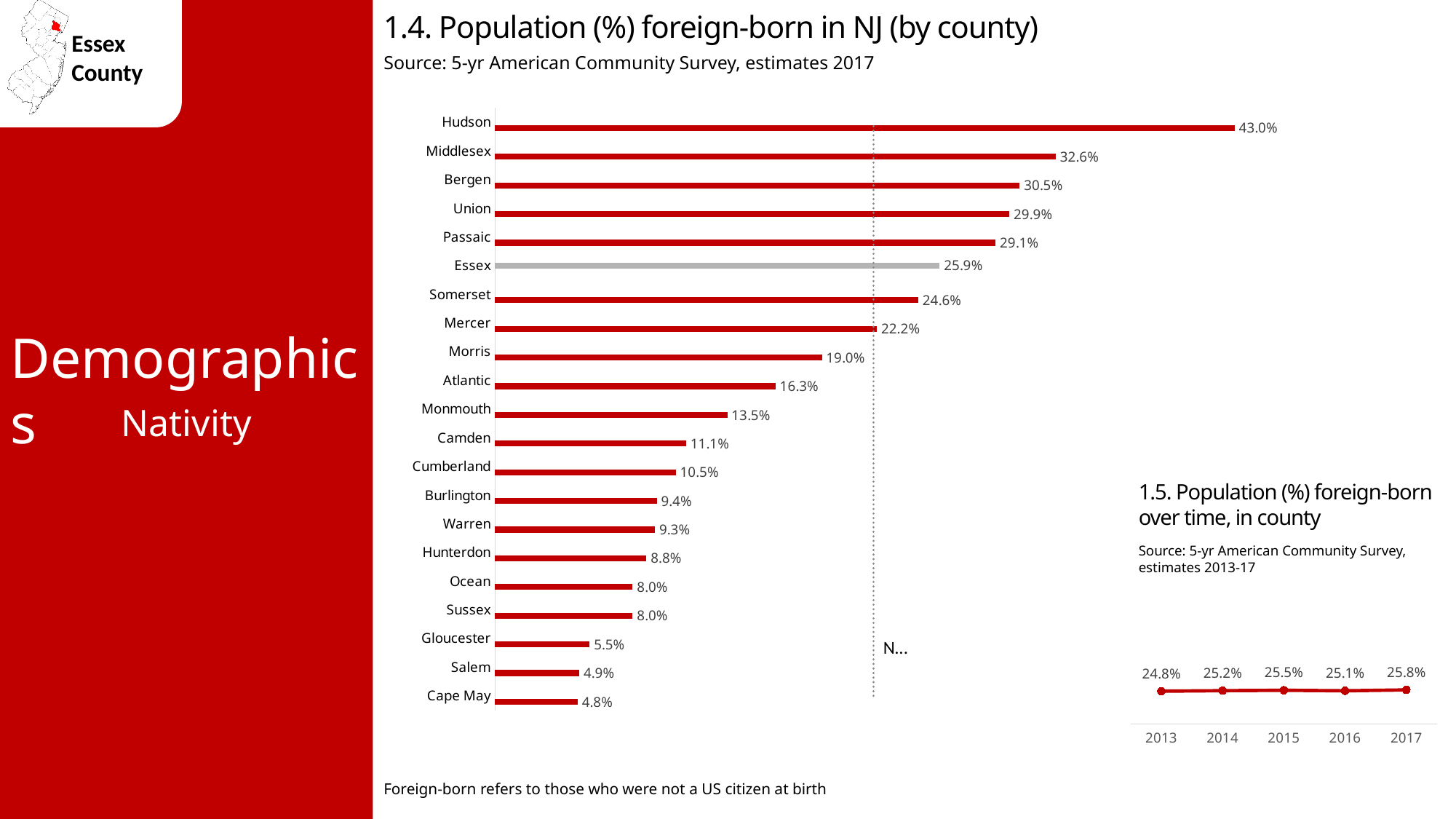
In the chart '1.4. Population (%) foreign-born in NJ (by county)', which county has the highest value? Hudson In the chart '1.4. Population (%) foreign-born in NJ (by county)', which county has the lowest value? Cape May In the chart '1.4. Population (%) foreign-born in NJ (by county)', what is the difference between Hudson and Middlesex? 10.4% In the chart '1.4. Population (%) foreign-born in NJ (by county)', what is the value for Essex? 25.9% In the chart '1.4. Population (%) foreign-born in NJ (by county)', which county's bar is shown in grey rather than red? Essex In the chart '1.5. Population (%) foreign-born over time, in county', which year has the highest value? 2017 What kind of chart is '1.4. Population (%) foreign-born in NJ (by county)'? Bar chart In the chart '1.5. Population (%) foreign-born over time, in county', what is the value for 2015? 25.5% In the chart '1.4. Population (%) foreign-born in NJ (by county)', what is the value for Morris? 19.0% In the chart '1.4. Population (%) foreign-born in NJ (by county)', which is larger, Bergen or Union? Bergen In the chart '1.4. Population (%) foreign-born in NJ (by county)', how many counties are shown? 21 In the chart '1.5. Population (%) foreign-born over time, in county', how many data points are plotted? 5